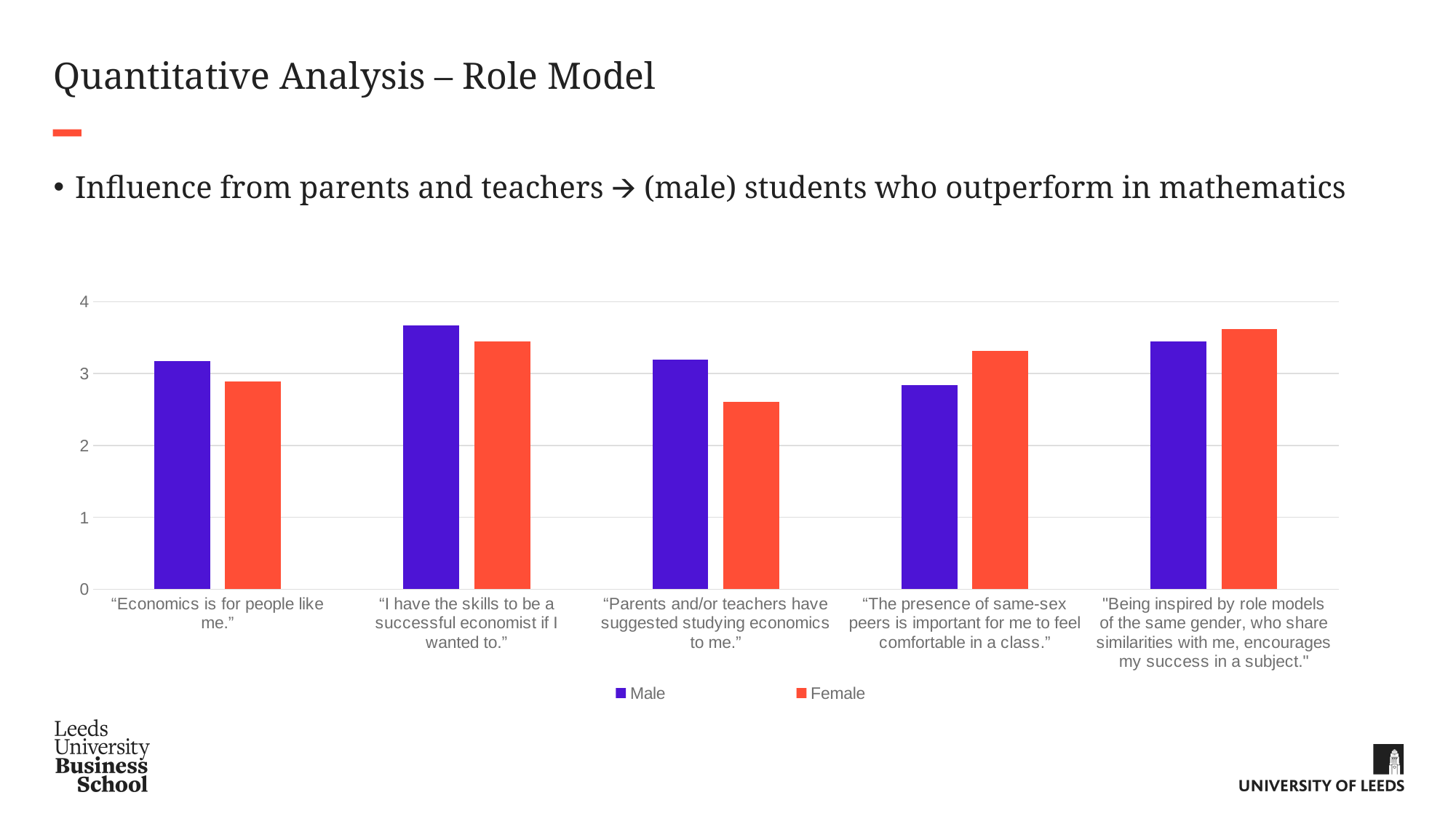
Which series has the higher value for "Parents and/or teachers have suggested studying economics to me."? Male For which statement is the Female value lowest? "Parents and/or teachers have suggested studying economics to me." Which series has the higher value for "The presence of same-sex peers is important for me to feel comfortable in a class."? Female Is the Male value for "I have the skills to be a successful economist if I wanted to." greater or less than 3? greater Which series has the higher value for "Economics is for people like me."? Male How many series does the legend list? 2 What kind of chart is shown on the slide? bar chart For which statement is the Male value lowest? "The presence of same-sex peers is important for me to feel comfortable in a class." What colour are the Female bars in the chart? orange-red How many statement categories are shown on the x axis? 5 Is the Female value for "Parents and/or teachers have suggested studying economics to me." greater or less than 3? less For which statement is the Male value highest? "I have the skills to be a successful economist if I wanted to."